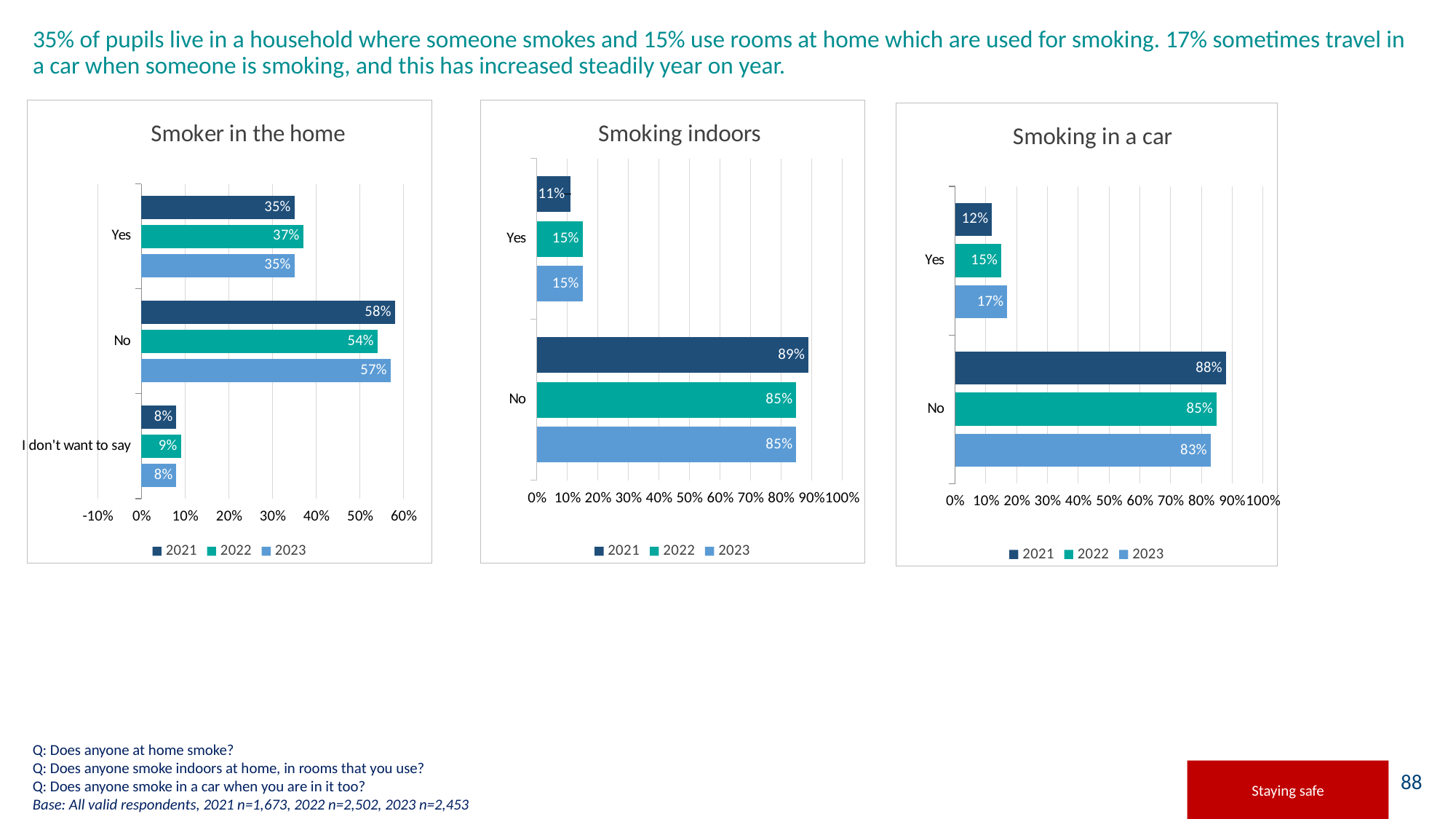
In the 'Smoking in a car' chart, what is the difference between the 'No' values for 2021 and 2023? 5% How many series does the legend list in the 'Smoking indoors' chart? 3 In the 'Smoking in a car' chart, what is the value for 'Yes' in 2023? 17% How many categories are shown in the 'Smoker in the home' chart? 3 In the 'Smoking in a car' chart, do the 'Yes' values rise or fall from 2021 to 2023? rise In the 'Smoker in the home' chart, what is the value for 'Yes' in 2023? 35% In the 'Smoker in the home' chart, is the 2022 value for 'No' larger or smaller than the 2023 value for 'No'? smaller What kind of chart is the 'Smoking in a car' chart? bar chart In the 'Smoking indoors' chart, what is the value for 'Yes' in 2021? 11% In the 'Smoker in the home' chart, what is the value for 'No' in 2021? 58% In the 'Smoking indoors' chart, which year has the highest value for 'No'? 2021 In the 'Smoker in the home' chart, which category has the lowest values across all years? I don't want to say